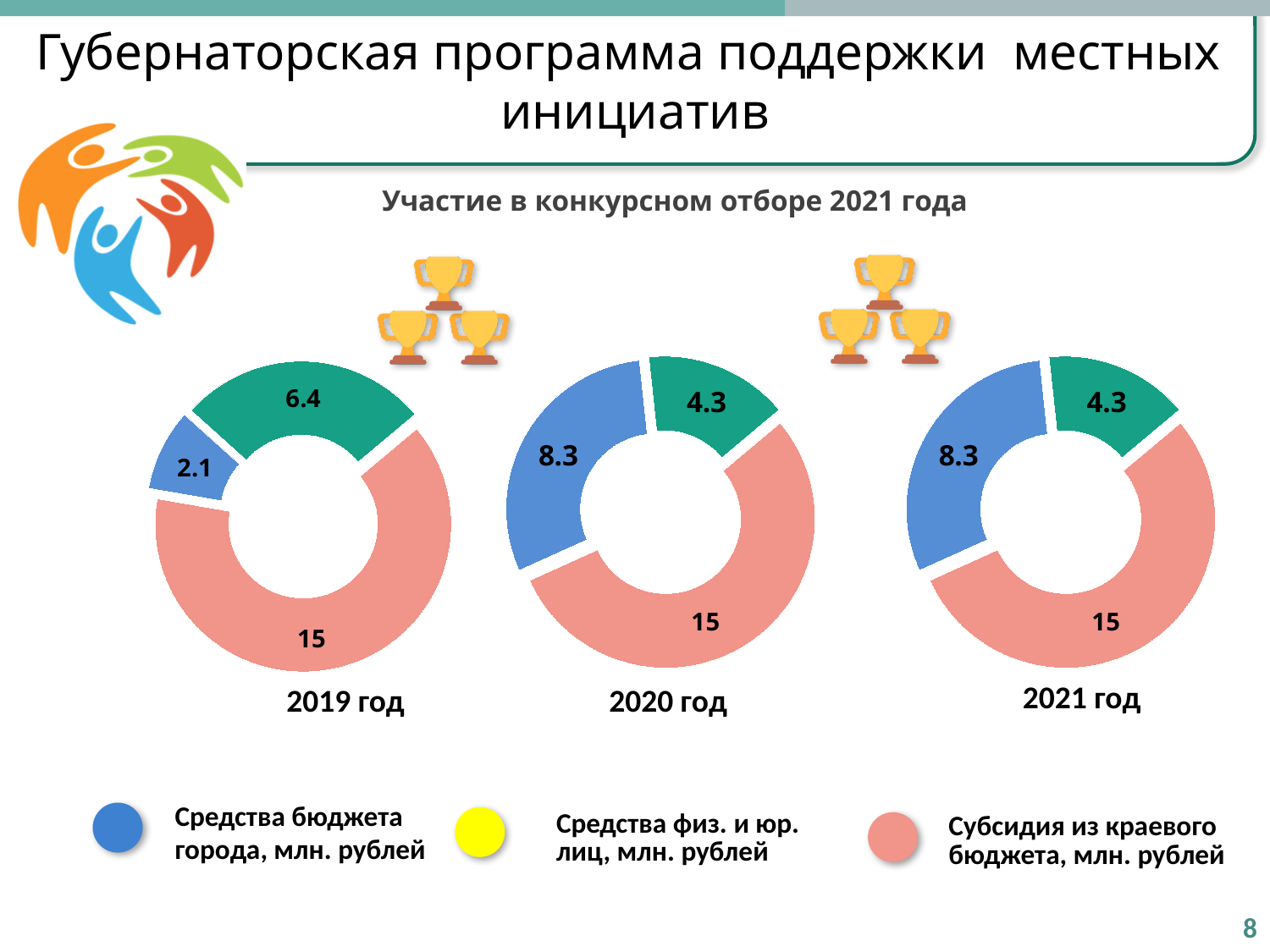
In the 2019 год chart, which slice has the smallest value? 2.1 (Средства бюджета города) How does the value for Средства бюджета города (blue slice) change from 2019 год to 2020 год? It rises from 2.1 to 8.3 In the 2021 год chart, what is the value for Субсидия из краевого бюджета (pink slice)? 15 In the 2020 год chart, what is the value for Средства бюджета города (blue slice)? 8.3 In the 2019 год chart, which slice has the largest value? 15 (Субсидия из краевого бюджета) In the 2019 год chart, what is the value of the green slice? 6.4 What is the total of all slices in the 2021 год chart? 27.6 How many slices does each donut chart on the slide have? 3 Which is larger in the 2019 год chart: the green slice or the blue slice? The green slice (6.4) What type of charts are shown on the slide? Donut (pie) charts In the 2019 год chart, what is the value of the blue slice (Средства бюджета города)? 2.1 In the 2020 год chart, what is the difference between the pink slice (15) and the blue slice (8.3)? 6.7